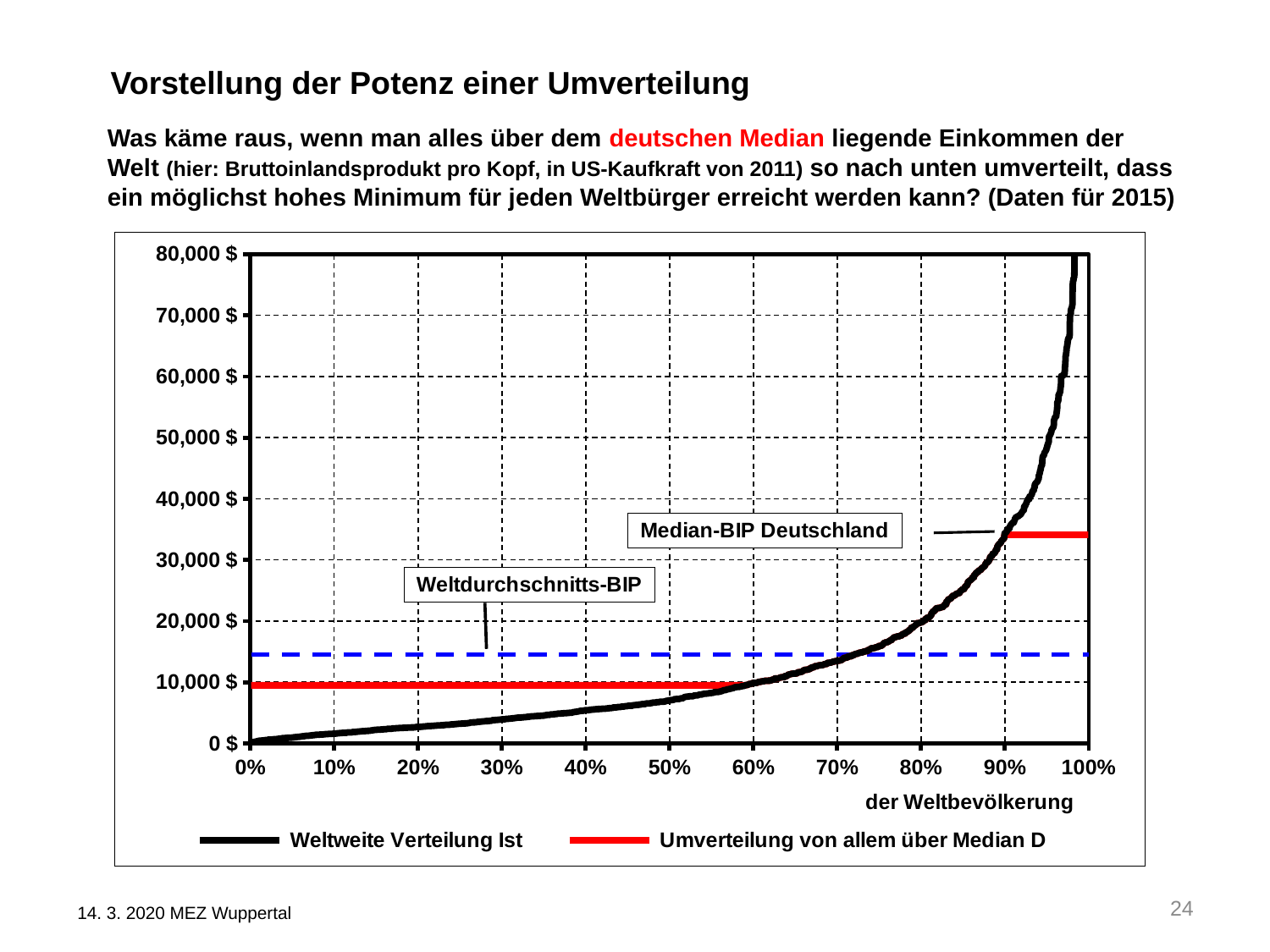
Is the value of 'Weltweite Verteilung Ist' at 30% of the world population greater or less than 10,000 $? less What kind of chart is shown on the slide? line chart Is the level of the 'Median-BIP Deutschland' line greater or less than 30,000 $? greater What colour is the line for 'Weltweite Verteilung Ist'? black What are the two series named in the legend? Weltweite Verteilung Ist; Umverteilung von allem über Median D Does the 'Weltweite Verteilung Ist' curve rise or fall as the share of the world population increases from 0% to 100%? rises How many percentage tick labels are shown on the x axis? 11 Is the value of 'Weltweite Verteilung Ist' at 70% of the world population greater or less than 20,000 $? less How many series does the legend list? 2